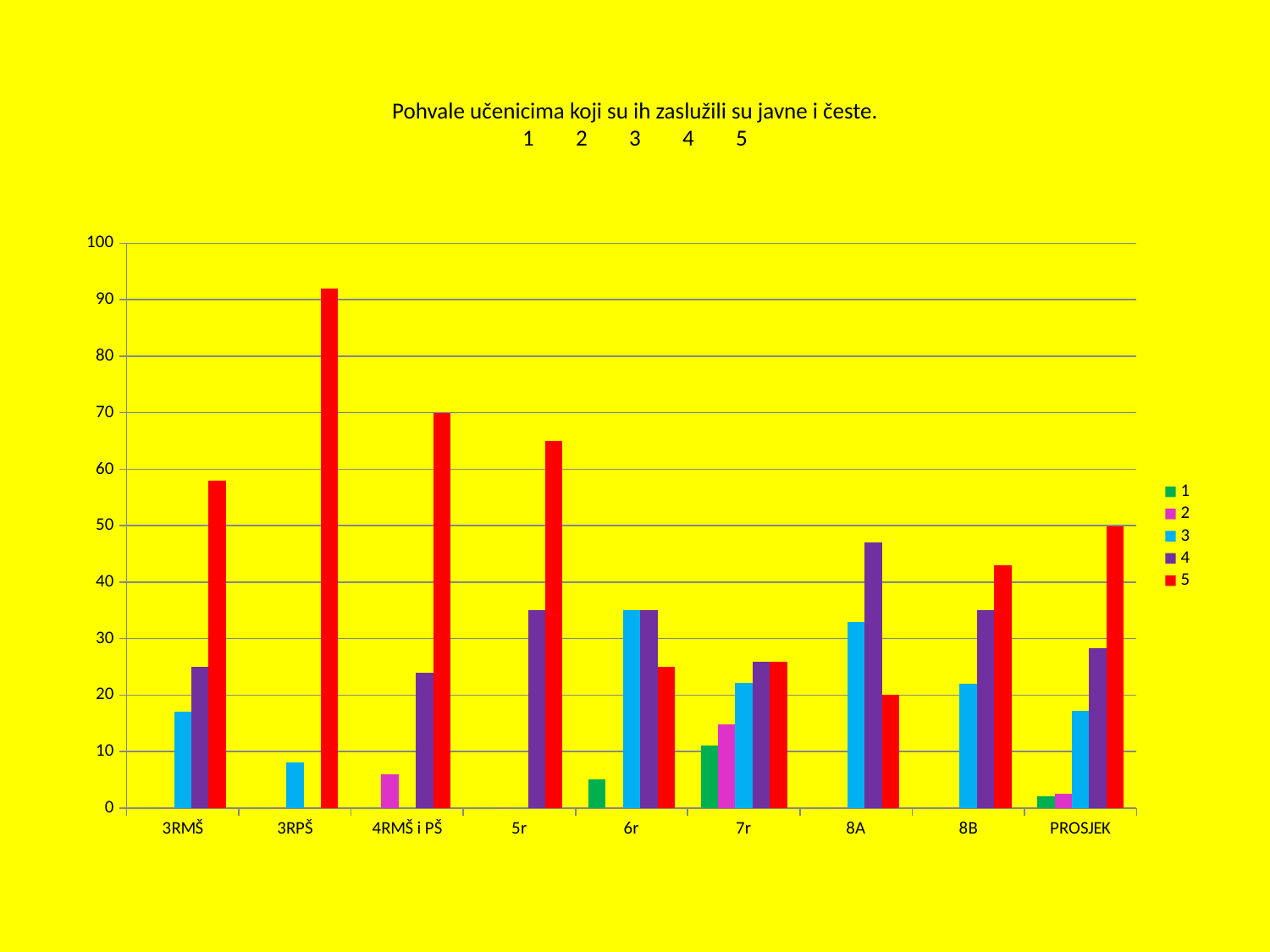
Is the value for series 5 in 3RMŠ greater or less than 50? greater Which category has the lowest bar for series 5? 8A How many categories are shown along the x axis? 9 How many series does the legend list? 5 Which is larger in 5r: series 4 or series 5? series 5 Is the value for series 5 in 3RPŠ greater or less than 90? greater Which is larger in 8A: series 4 or series 5? series 4 What is the title of the chart? Pohvale učenicima koji su ih zaslužili su javne i česte. Is the value for series 4 in 8A greater or less than 40? greater What kind of chart is shown on the slide? bar chart Which category has the tallest bar for series 5? 3RPŠ